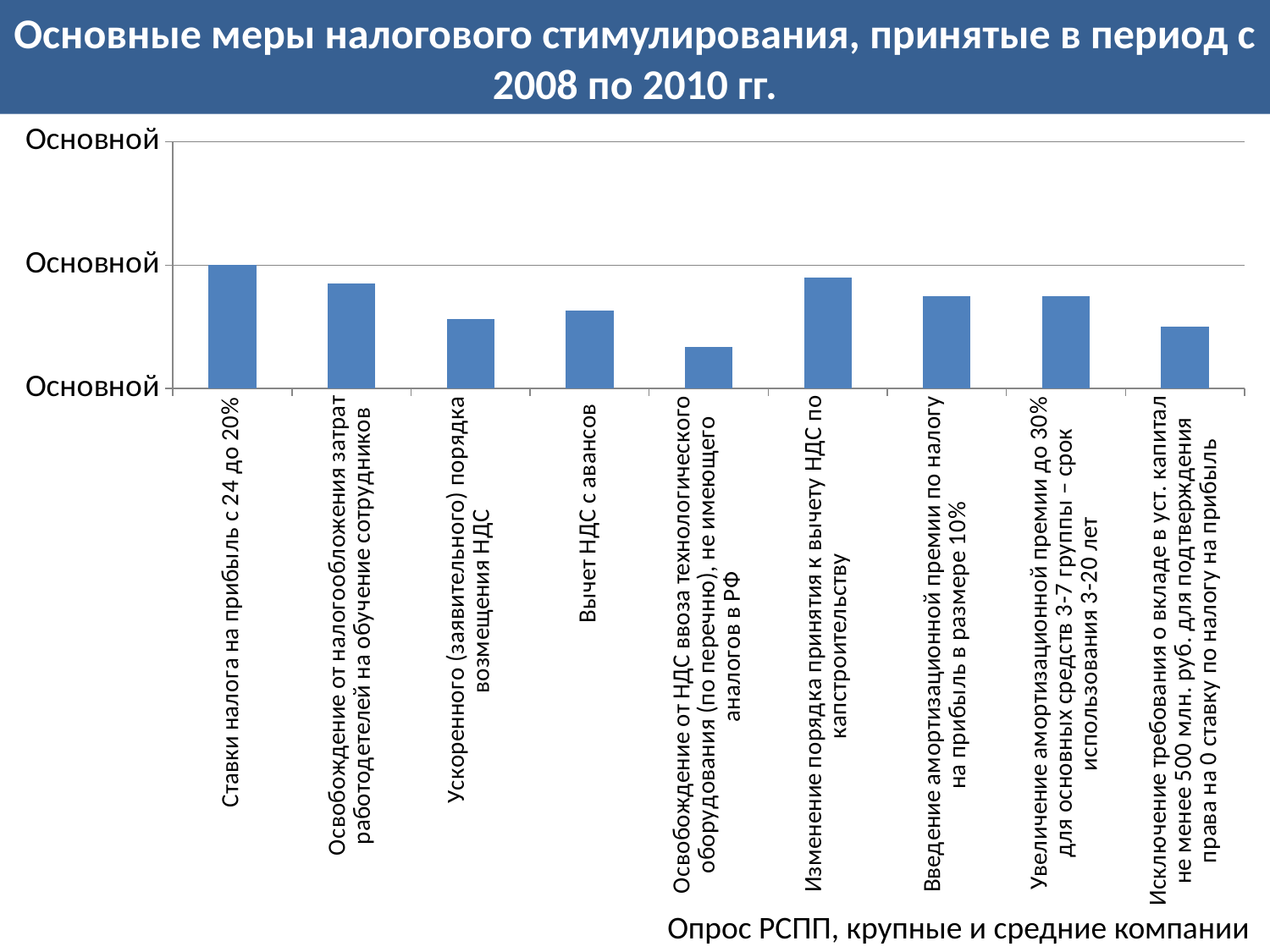
Which bar is taller: "Освобождение от налогообложения затрат работодателей на обучение сотрудников" or "Исключение требования о вкладе в уст. капитал не менее 500 млн. руб. для подтверждения права на 0 ставку по налогу на прибыль"? Освобождение от налогообложения затрат работодателей на обучение сотрудников What kind of chart is shown on the slide? Bar chart Which bar is taller: "Введение амортизационной премии по налогу на прибыль в размере 10%" or "Освобождение от НДС ввоза технологического оборудования (по перечню), не имеющего аналогов в РФ"? Введение амортизационной премии по налогу на прибыль в размере 10% Which measure has the highest bar on the chart? Ставки налога на прибыль с 24 до 20% What is the title of the slide containing the chart? Основные меры налогового стимулирования, принятые в период с 2008 по 2010 гг. Which bar is taller: "Ставки налога на прибыль с 24 до 20%" or "Освобождение от НДС ввоза технологического оборудования (по перечню), не имеющего аналогов в РФ"? Ставки налога на прибыль с 24 до 20% What source is cited below the chart? Опрос РСПП, крупные и средние компании How many tax stimulus measures (categories) are plotted on the chart? 9 Which measure has the lowest bar on the chart? Освобождение от НДС ввоза технологического оборудования (по перечню), не имеющего аналогов в РФ